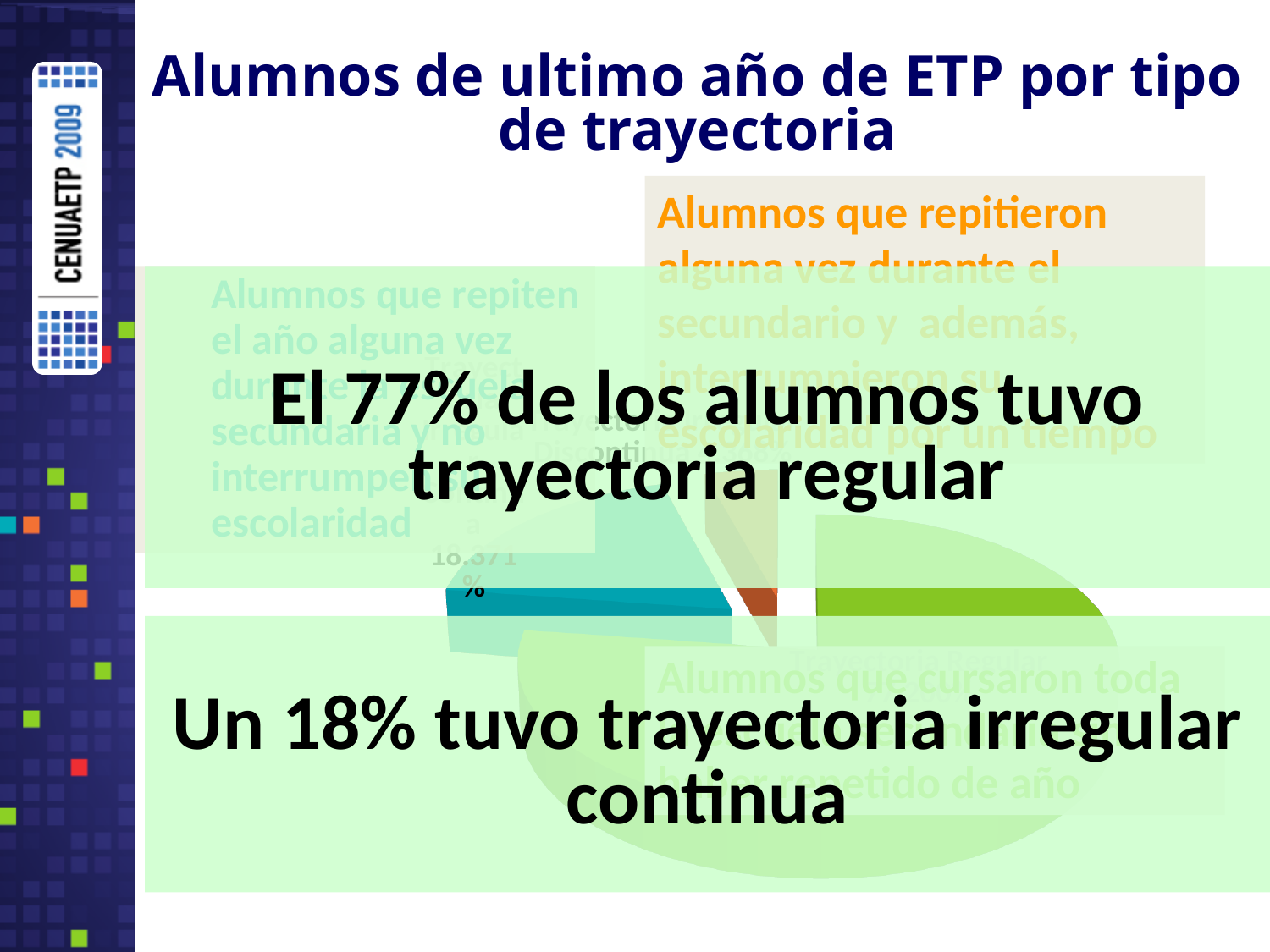
Which slice is larger in the pie chart, the green slice or the teal slice? green What kind of chart is shown on the slide? pie chart What is the title of the slide containing the pie chart? Alumnos de ultimo año de ETP por tipo de trayectoria Which slice is larger in the pie chart, the teal slice or the brown slice? teal According to the slide, what percentage of students had an irregular continuous trajectory? 18% Which colour slice is the smallest in the pie chart? brown Is the green slice of the pie chart greater or less than half of the pie? greater Which colour slice is the largest in the pie chart? green How many slices does the pie chart have? 3 According to the slide, what percentage of students had a regular trajectory? 77%